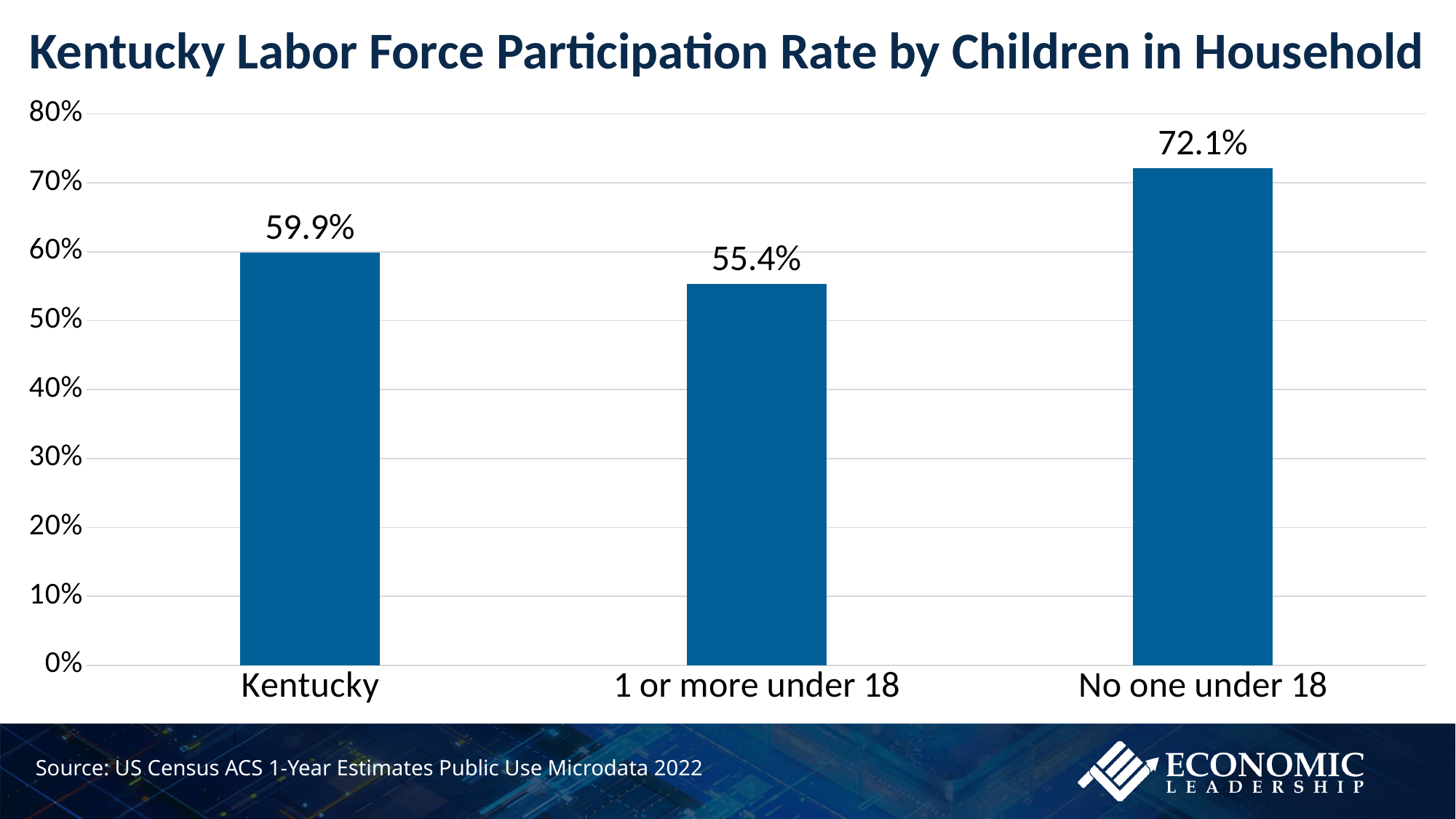
Which category has the lowest labor force participation rate? 1 or more under 18 What is the difference in percentage points between the rate for No one under 18 and the rate for 1 or more under 18? 16.7 percentage points Is the value for No one under 18 greater or less than 70%? greater How many categories are shown on the chart? 3 Which category has the highest labor force participation rate? No one under 18 What is the labor force participation rate for households with no one under 18? 72.1% What is the labor force participation rate for households with 1 or more under 18? 55.4% What kind of chart is shown on the slide? Bar chart What is the difference in percentage points between the Kentucky rate and the rate for 1 or more under 18? 4.5 percentage points Which is larger, the rate for Kentucky or the rate for 1 or more under 18? Kentucky What is the labor force participation rate for Kentucky overall? 59.9% What is the title of the chart? Kentucky Labor Force Participation Rate by Children in Household